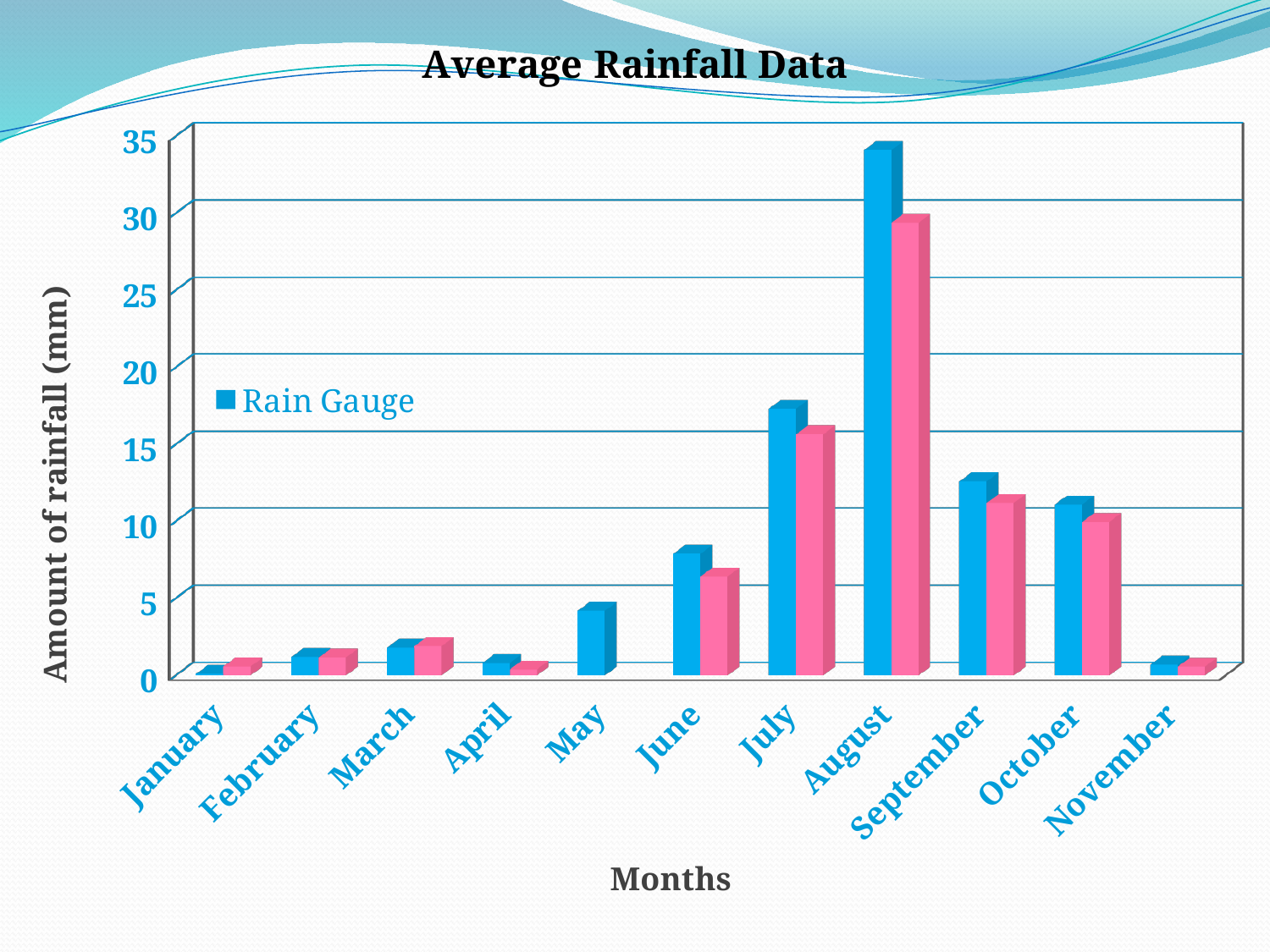
How many months are shown on the x axis of the chart? 11 Is the blue Rain Gauge value for August greater or less than 30? greater Which month has the highest rainfall value in the chart? August What kind of chart is shown on the slide? bar chart Do the rainfall values rise or fall from May to August? rise Is the blue Rain Gauge value for July greater or less than 15? greater Is the blue Rain Gauge value for June greater or less than 10? less In August, which bar is taller, the blue bar or the pink bar? the blue bar Which month has the larger blue Rain Gauge value, July or August? August How many series does the legend list? 1 What is the label on the vertical axis of the chart? Amount of rainfall (mm)